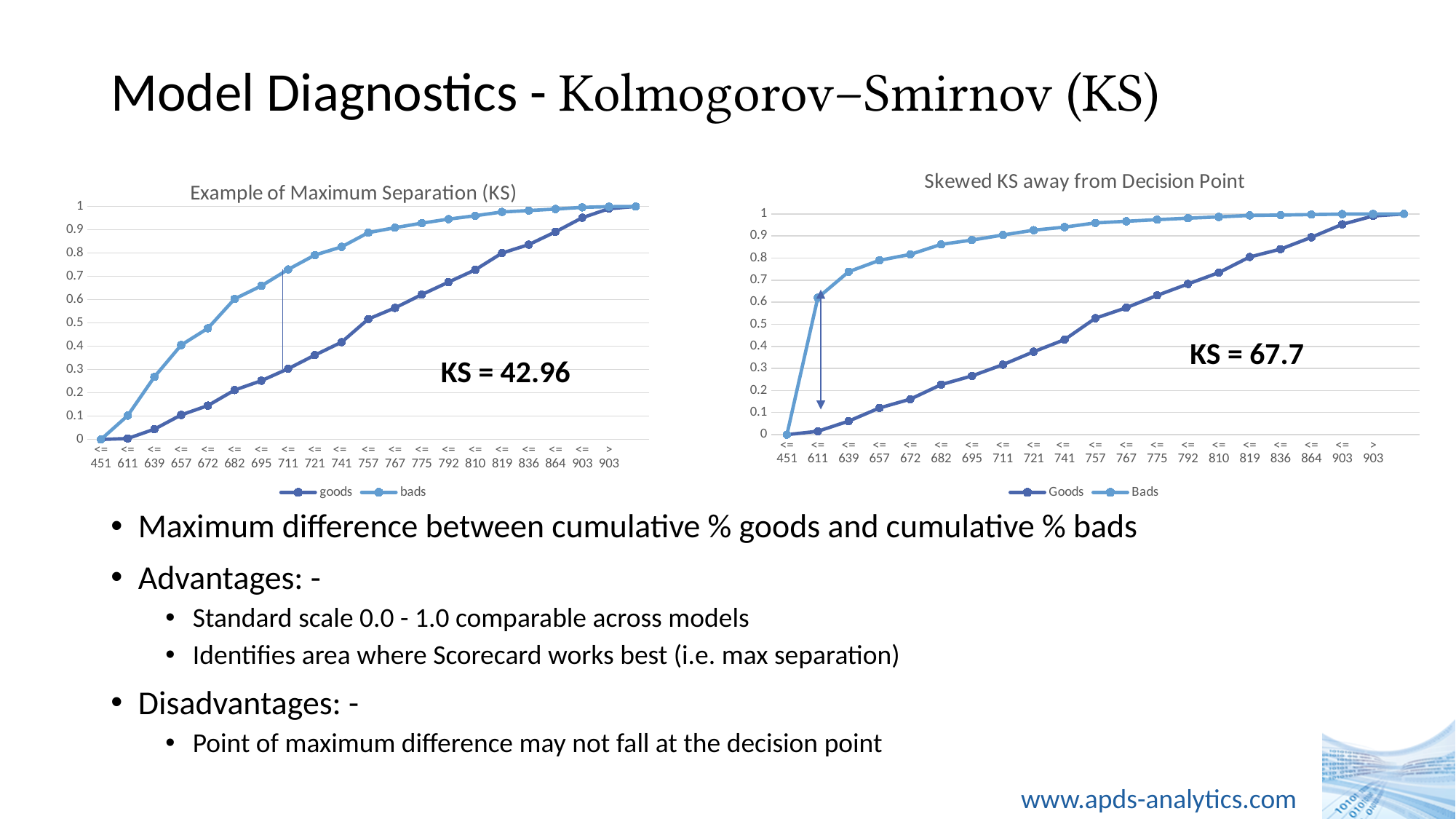
In the left chart 'Example of Maximum Separation (KS)', what KS value is printed on the chart? KS = 42.96 What kind of chart is the left chart titled 'Example of Maximum Separation (KS)'? line chart In the right chart 'Skewed KS away from Decision Point', is the value of the Bads series at '<= 611' greater or less than 0.5? greater How many score-band categories are shown on the x axis of the right chart 'Skewed KS away from Decision Point'? 20 In the right chart 'Skewed KS away from Decision Point', what KS value is printed on the chart? KS = 67.7 In the left chart 'Example of Maximum Separation (KS)', is the value of the goods series at '<= 711' greater or less than 0.5? less In the right chart 'Skewed KS away from Decision Point', which series has the larger value at '<= 695', Goods or Bads? Bads In the left chart 'Example of Maximum Separation (KS)', do the values of the goods series rise or fall as you move along the x axis from '<= 451' to '> 903'? rise How many series does the legend of the right chart 'Skewed KS away from Decision Point' list? 2 What are the two series named in the legend of the left chart 'Example of Maximum Separation (KS)'? goods and bads In the right chart 'Skewed KS away from Decision Point', is the value of the Goods series at '<= 611' greater or less than 0.1? less